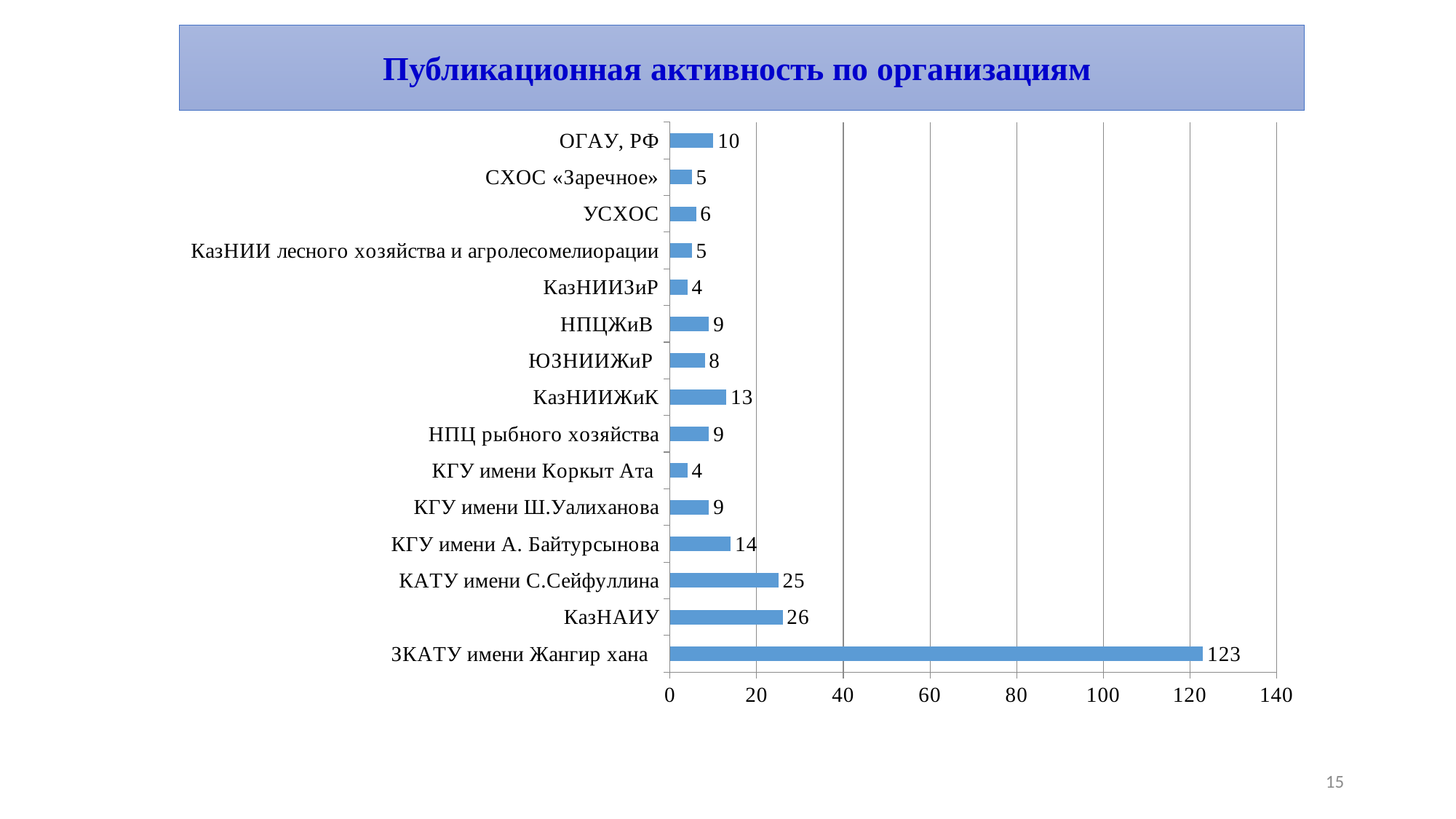
What is the value for КГУ имени А. Байтурсынова? 14 What is the value for КазНАИУ? 26 What kind of chart is shown on the slide? bar chart How many organizations are shown in the chart? 15 What is the title of the chart? Публикационная активность по организациям What is the difference between the values for КазНИИЖиК and ЮЗНИИЖиР? 5 What is the difference between the values for ЗКАТУ имени Жангир хана and КазНАИУ? 97 What is the value for ЗКАТУ имени Жангир хана? 123 Is the value for ЗКАТУ имени Жангир хана greater or less than 100? greater Which organization has the highest value? ЗКАТУ имени Жангир хана Which is larger, the value for КАТУ имени С.Сейфуллина or the value for КГУ имени А. Байтурсынова? КАТУ имени С.Сейфуллина What is the value for ОГАУ, РФ? 10